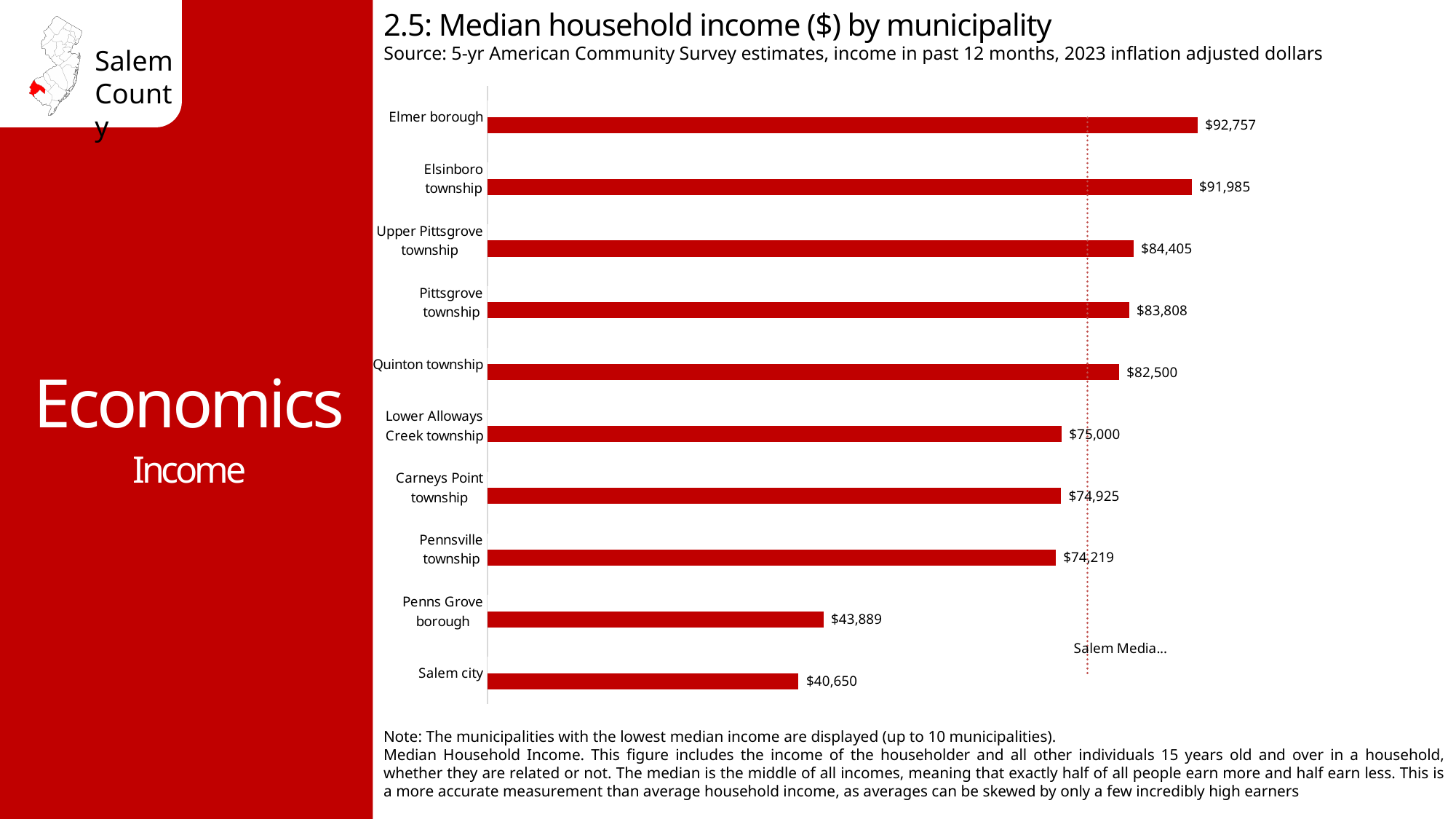
How many municipalities are shown on the chart? 10 What is the difference in median household income between Upper Pittsgrove township and Pittsgrove township? $597 Which has a higher median household income, Lower Alloways Creek township or Pennsville township? Lower Alloways Creek township Which municipality has the highest median household income on the chart? Elmer borough What is the title of the chart? 2.5: Median household income ($) by municipality Which municipality has the lowest median household income on the chart? Salem city What type of chart is used to show median household income by municipality? Bar chart What is the median household income for Penns Grove borough? $43,889 What is the median household income for Salem city? $40,650 What is the median household income for Quinton township? $82,500 What is the difference in median household income between Elmer borough and Salem city? $52,107 What is the median household income for Elmer borough? $92,757